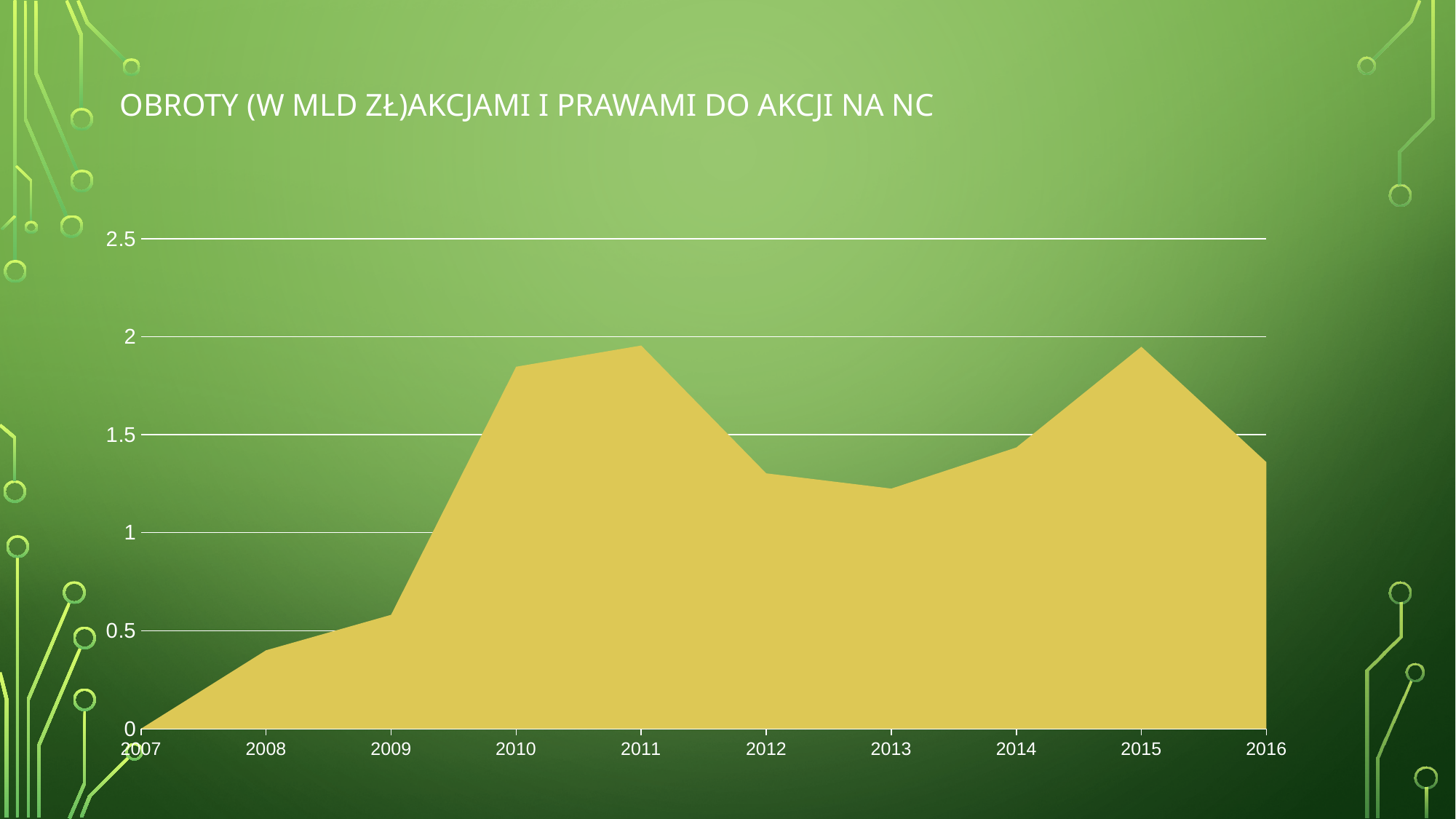
Is the value for 2013 greater or less than 1? greater Which year has the larger value, 2013 or 2014? 2014 Is the value for 2010 greater or less than 1.5? greater Is the value for 2012 greater or less than 1.5? less Do the values rise or fall from 2007 to 2011? rise What is the title of the chart? OBROTY (W MLD ZŁ)AKCJAMI I PRAWAMI DO AKCJI NA NC Which year has the lowest value? 2007 Which year has the larger value, 2010 or 2012? 2010 How many years are plotted along the x axis? 10 What kind of chart is shown on the slide? area chart